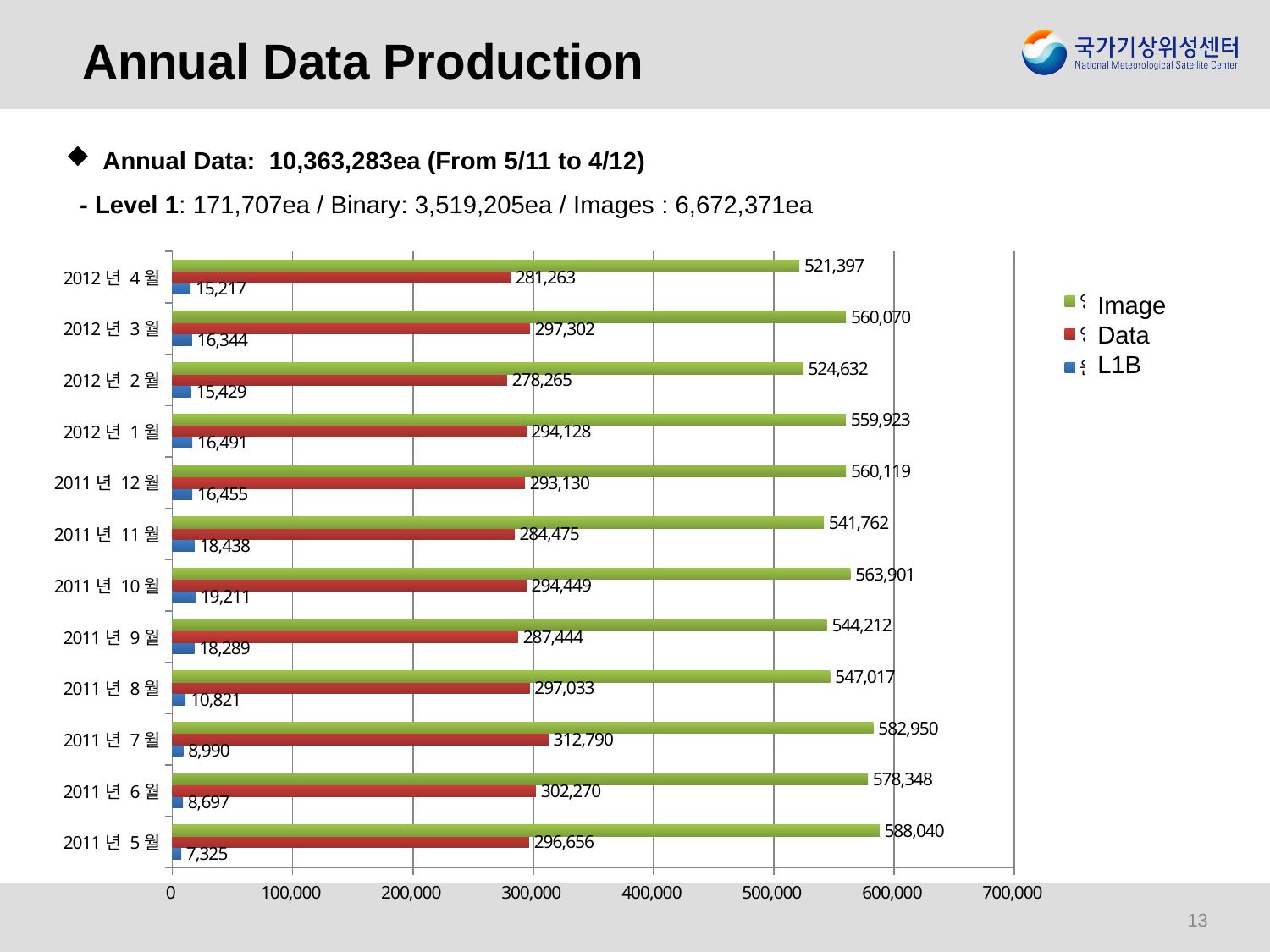
Which month has the lowest Data value? 2012년 2월 What is the Data value for 2011년 7월? 312,790 How many months are shown on the chart? 12 What is the difference between the Image values for 2011년 5월 and 2012년 4월? 66,643 Which month has the highest Image value? 2011년 5월 What is the L1B value for 2011년 10월? 19,211 What kind of chart is shown on the slide? bar chart How many series does the legend list? 3 What is the Image value for 2012년 4월? 521,397 Which is larger, the Data value for 2011년 7월 or for 2012년 2월? 2011년 7월 Is the Image value for 2011년 7월 greater or less than 500,000? greater Which month has the lowest L1B value? 2011년 5월